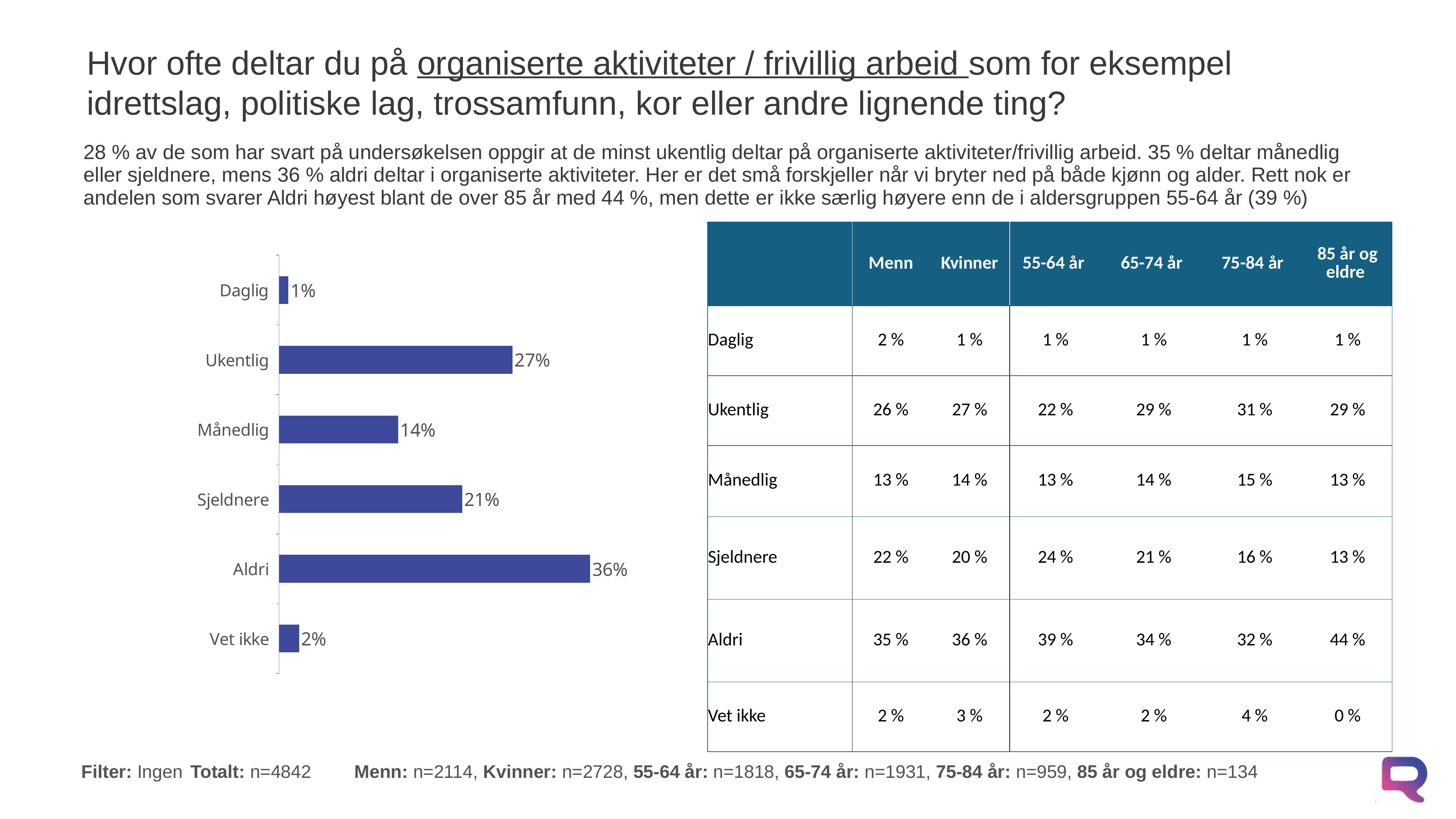
Which category has the lowest value in the bar chart? Daglig Which category has the highest value in the bar chart? Aldri What is the value for Ukentlig in the bar chart? 27% What colour are the bars in the chart? Blue What is the value for Månedlig in the bar chart? 14% What is the value for Aldri in the bar chart? 36% What kind of chart is shown on the slide? Bar chart What is the difference between the values for Sjeldnere and Månedlig in the bar chart? 7% What is the value for Vet ikke in the bar chart? 2% Which is larger in the bar chart, Sjeldnere or Månedlig? Sjeldnere How many categories are shown in the bar chart? 6 What is the difference between the values for Aldri and Ukentlig in the bar chart? 9%